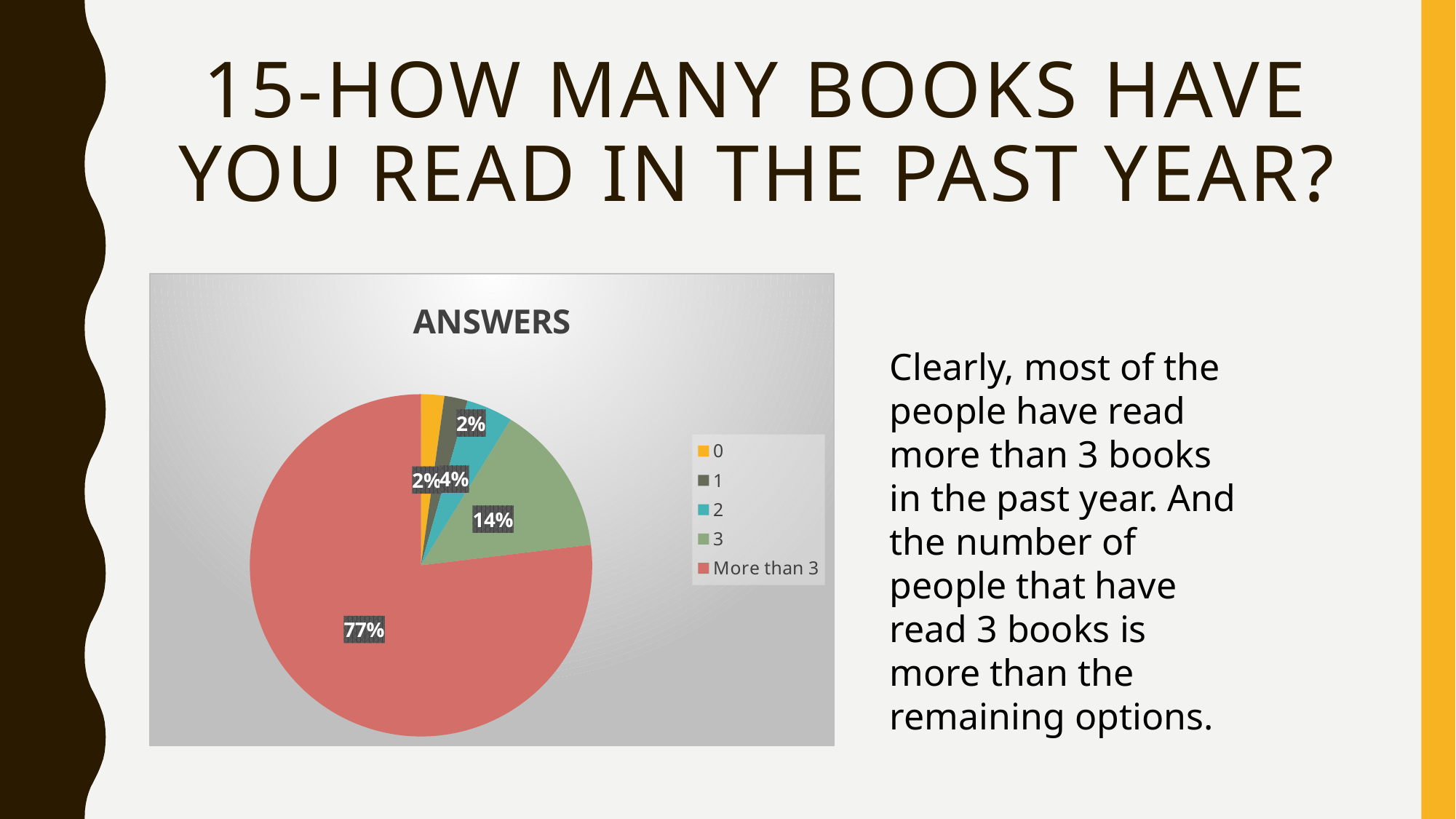
What kind of chart is shown on the slide? pie chart What colour is the slice for 'More than 3'? red Which category has the largest share of the pie? More than 3 What percentage of answers is '2'? 4% What percentage of answers is 'More than 3'? 77% What is the title of the chart? ANSWERS Which is larger, the share for '3' or the share for '2'? 3 How many categories does the pie chart's legend list? 5 What percentage of answers is '3'? 14% Is the share for 'More than 3' greater or less than 50%? greater What percentage of answers is '0'? 2% What is the difference between the share for 'More than 3' and the share for '3'? 63%